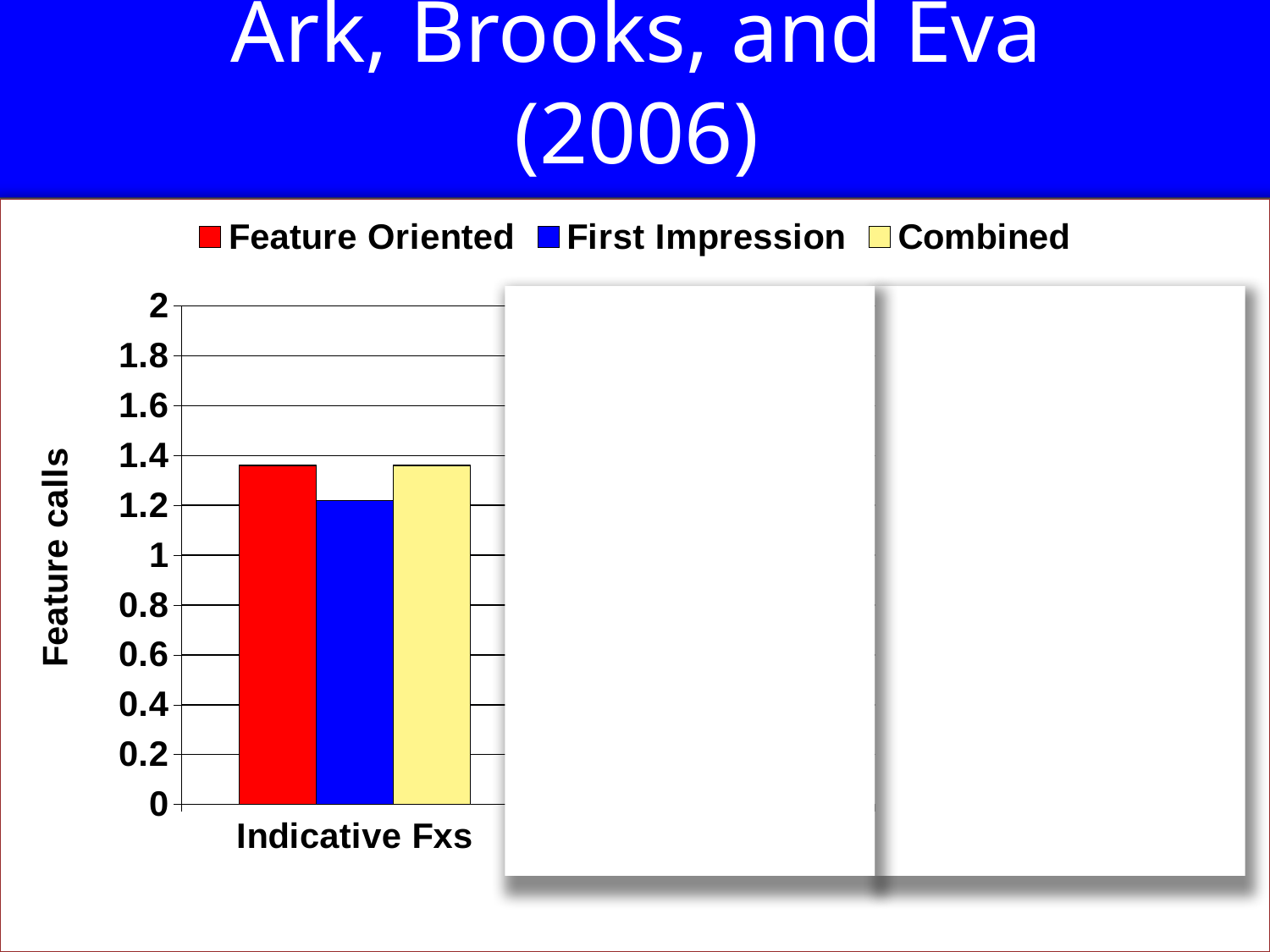
What kind of chart is shown on the slide? bar chart For Indicative Fxs, is the value for Feature Oriented greater or less than 1.2? greater How many series does the legend list? 3 For Indicative Fxs, is the value for First Impression greater or less than 1? greater For Indicative Fxs, is the value for Combined greater or less than 1.6? less What is the label on the vertical axis? Feature calls For Indicative Fxs, which is larger: Feature Oriented or First Impression? Feature Oriented What is the highest value shown on the vertical axis? 2 For the Indicative Fxs category, which series has the lowest value? First Impression What are the three series named in the legend? Feature Oriented, First Impression, Combined For Indicative Fxs, which is larger: Combined or First Impression? Combined